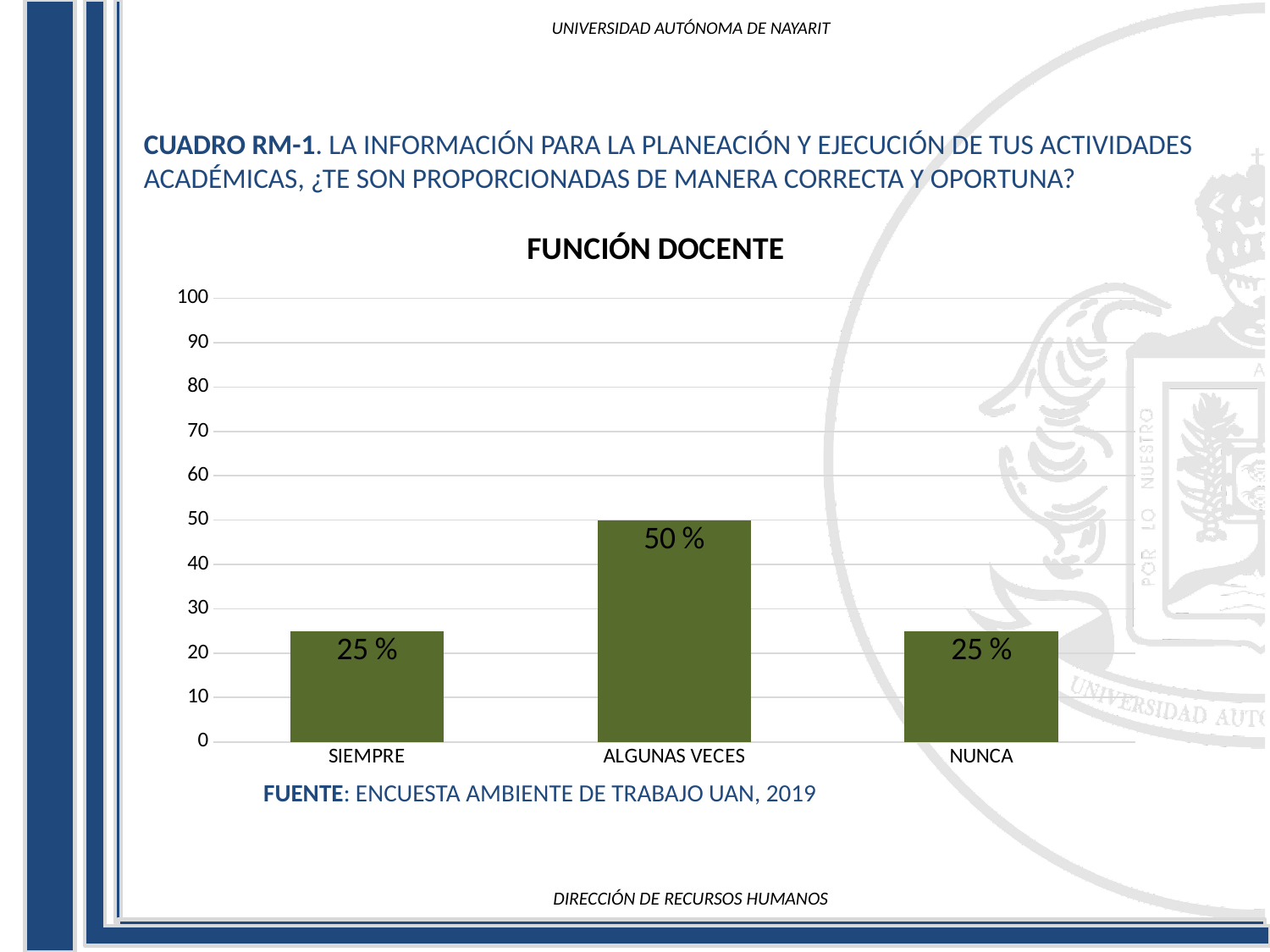
What is the value for SIEMPRE? 25 % What is the title of the chart? FUNCIÓN DOCENTE What kind of chart is shown on the slide? bar chart Is the value for ALGUNAS VECES greater or less than 40? greater What is the value for ALGUNAS VECES? 50 % What is the value for NUNCA? 25 % How many categories are shown on the x axis? 3 Which category has the highest value? ALGUNAS VECES What is the highest value shown on the y axis? 100 What is the difference between the values for ALGUNAS VECES and SIEMPRE? 25 % Is the value for SIEMPRE greater or less than 30? less Which is larger, the value for ALGUNAS VECES or the value for NUNCA? ALGUNAS VECES